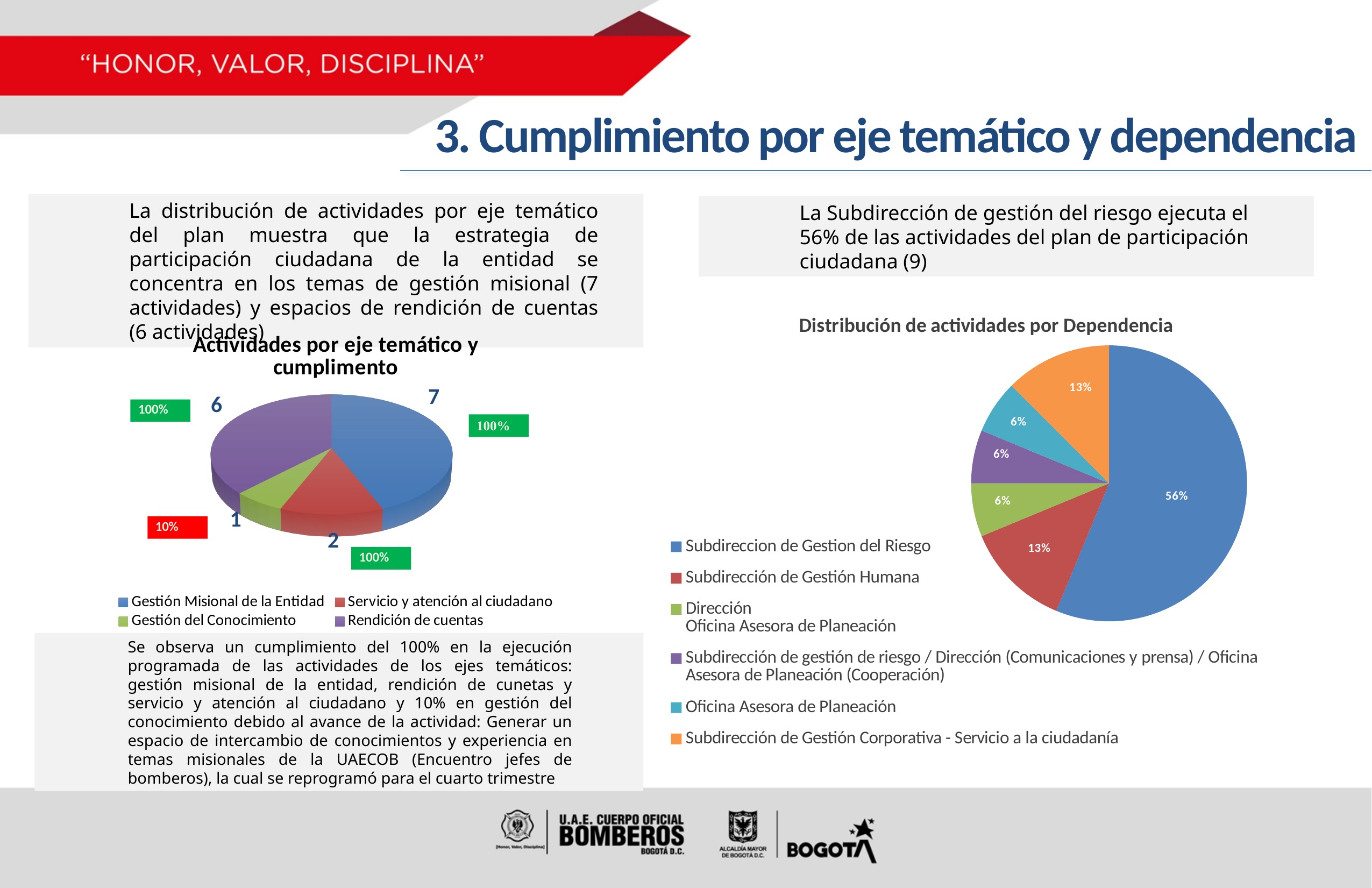
In the chart titled 'Actividades por eje temático y cumplimento', how many activities are in Rendición de cuentas? 6 In the chart titled 'Actividades por eje temático y cumplimento', how many activities are in Gestión Misional de la Entidad? 7 In the chart titled 'Distribución de actividades por Dependencia', which is larger: the share for Subdirección de Gestión Corporativa - Servicio a la ciudadanía or the share for Oficina Asesora de Planeación? Subdirección de Gestión Corporativa - Servicio a la ciudadanía What kind of chart is 'Actividades por eje temático y cumplimento'? Pie chart In the chart titled 'Distribución de actividades por Dependencia', what share of activities belongs to Subdireccion de Gestion del Riesgo? 56% In the chart titled 'Actividades por eje temático y cumplimento', what is the difference between the number of activities in Gestión Misional de la Entidad and Servicio y atención al ciudadano? 5 In the chart titled 'Distribución de actividades por Dependencia', how many dependencies does the legend list? 6 In the chart titled 'Actividades por eje temático y cumplimento', which category has the most activities? Gestión Misional de la Entidad In the chart titled 'Distribución de actividades por Dependencia', what share of activities belongs to Subdirección de Gestión Humana? 13% In the chart titled 'Actividades por eje temático y cumplimento', how many categories does the legend list? 4 In the chart titled 'Distribución de actividades por Dependencia', which dependency has the largest share? Subdireccion de Gestion del Riesgo In the chart titled 'Actividades por eje temático y cumplimento', which category has the fewest activities? Gestión del Conocimiento